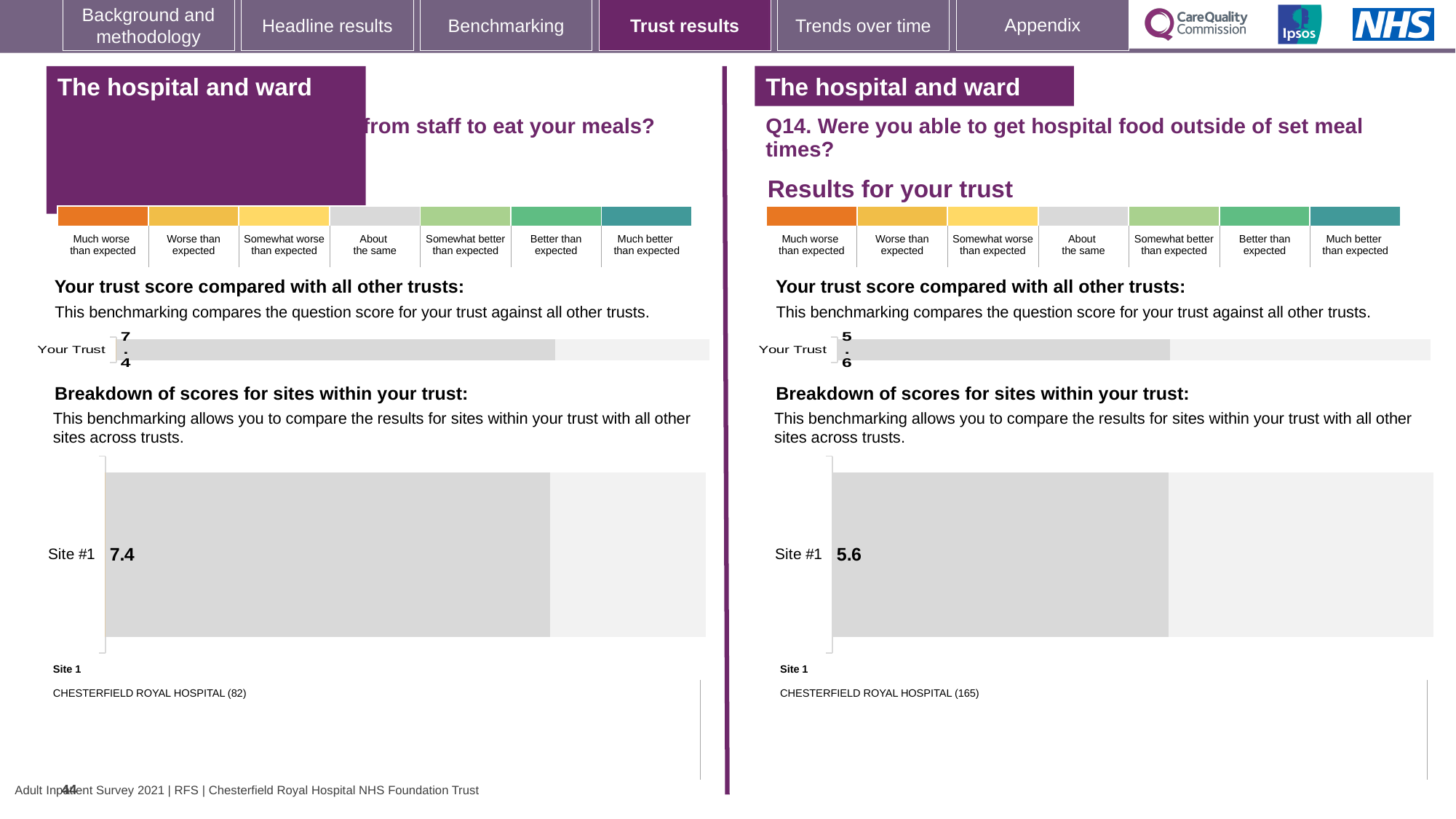
On the left half of the slide, what is the score shown for Your Trust? 7.4 What type of chart is used to show the Site #1 score on the right half of the slide (Q14)? Bar chart On the right half of the slide (Q14, hospital food outside of set meal times), what is the score shown for Your Trust? 5.6 In the right 'Breakdown of scores for sites within your trust' chart for Q14, what is the value for Site #1? 5.6 Which site is listed as Site 1 beneath the left chart? CHESTERFIELD ROYAL HOSPITAL (82) In the left 'Breakdown of scores for sites within your trust' chart, what is the value for Site #1? 7.4 How many sites are shown in the left 'Breakdown of scores for sites within your trust' chart? 1 Which is larger: the Your Trust score on the left half of the slide or the Your Trust score on the right half (Q14)? Left (7.4) Which site is listed as Site 1 beneath the right chart for Q14? CHESTERFIELD ROYAL HOSPITAL (165) What is the difference between the Site #1 score on the left half of the slide and the Site #1 score on the right half (Q14)? 1.8 Is the Your Trust score on the right half of the slide (Q14) greater or less than 6? less How many sites are shown in the right 'Breakdown of scores for sites within your trust' chart for Q14? 1